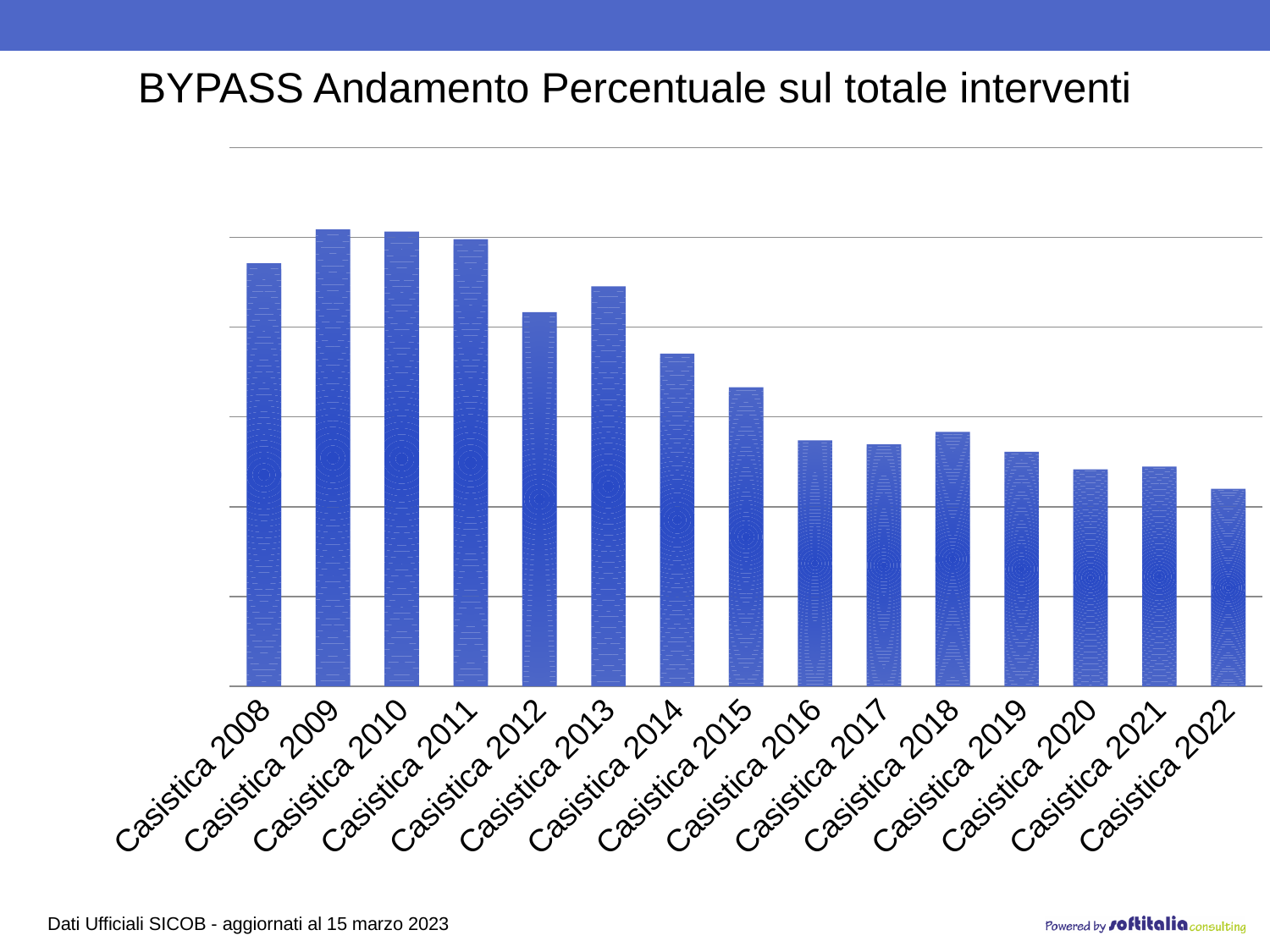
Which is larger, the value for Casistica 2008 or the value for Casistica 2012? Casistica 2008 Which is larger, the value for Casistica 2013 or the value for Casistica 2014? Casistica 2013 What is the title of the chart? BYPASS Andamento Percentuale sul totale interventi Which is larger, the value for Casistica 2015 or the value for Casistica 2022? Casistica 2015 Which category has the lowest value in the chart? Casistica 2022 What kind of chart is shown on the slide? Bar chart How many categories (bars) are plotted in the chart? 15 Overall, do the values rise or fall from Casistica 2008 to Casistica 2022? Fall What is the first category on the x axis of the chart? Casistica 2008